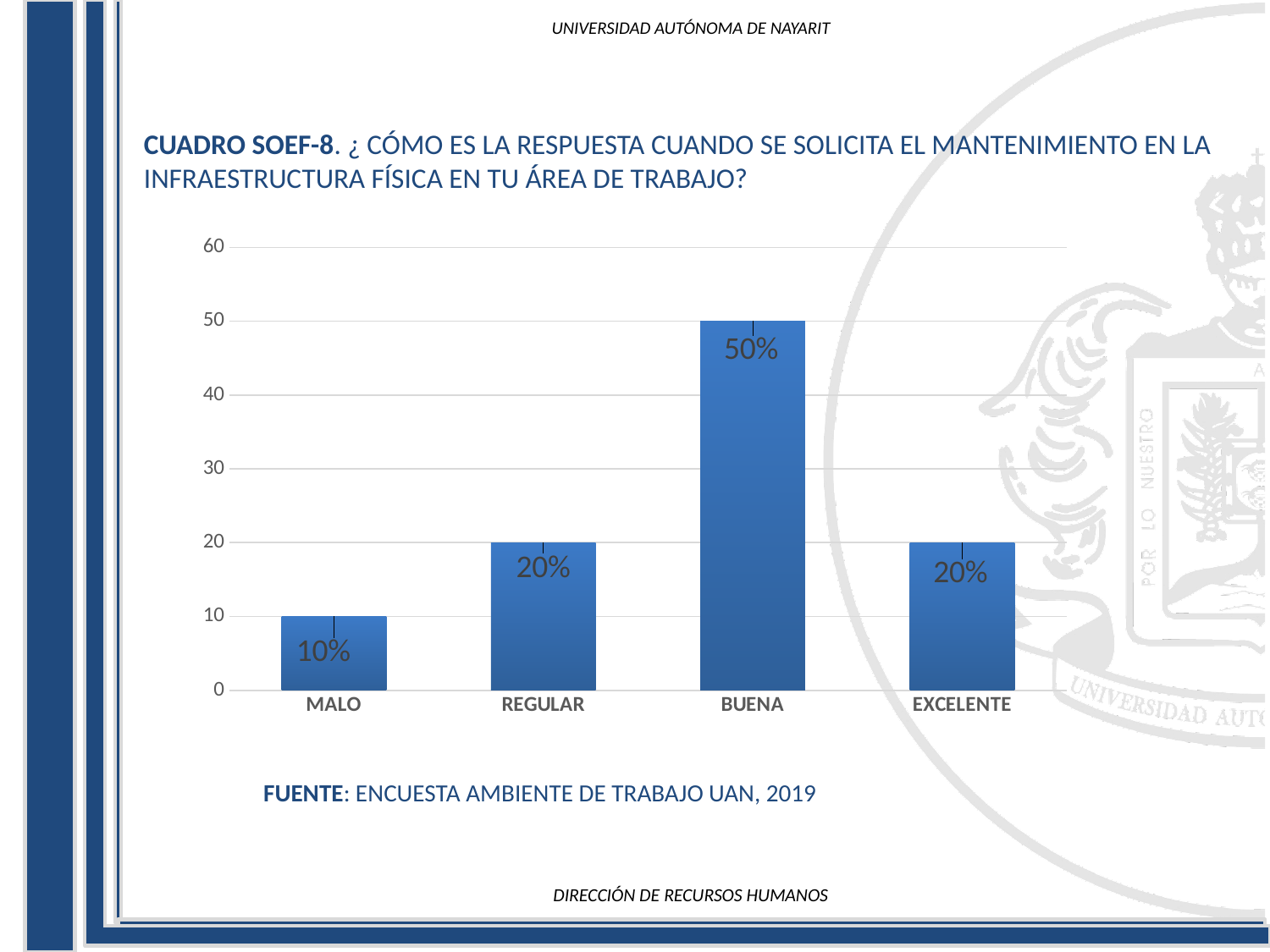
What is the value for REGULAR? 20% What is the value for EXCELENTE? 20% What kind of chart is shown on the slide? bar chart What is the difference between the values for BUENA and MALO? 40% What is the value for BUENA? 50% Which is larger, the value for BUENA or the value for EXCELENTE? BUENA Which category has the lowest value? MALO What is the difference between the values for REGULAR and MALO? 10% Is the value for BUENA greater or less than 40? greater How many categories are shown on the x axis? 4 What is the value for MALO? 10% Which category has the highest value? BUENA